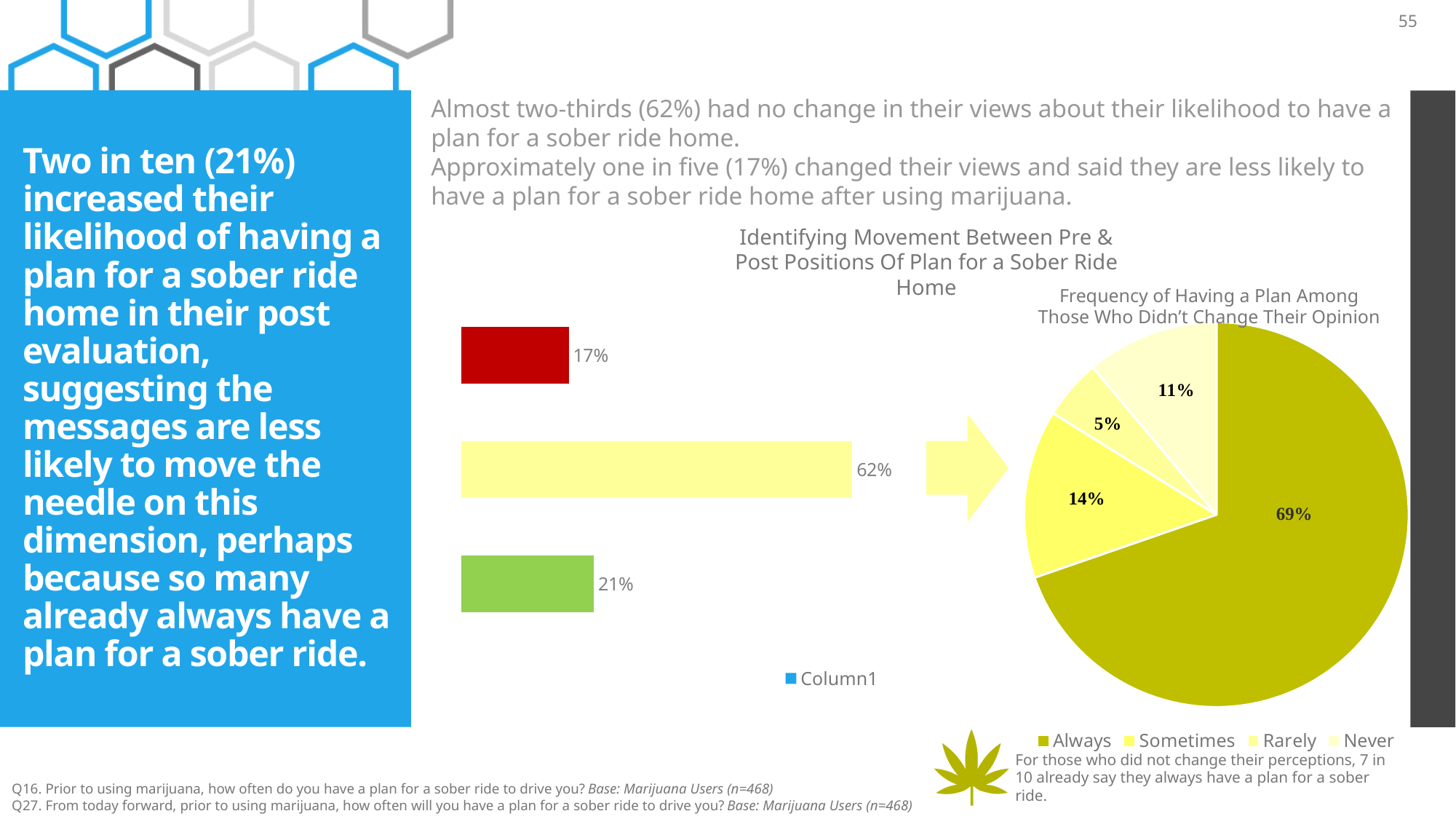
In the bar chart 'Identifying Movement Between Pre & Post Positions Of Plan for a Sober Ride Home', what value is labelled on the middle (yellow) bar? 62% In the bar chart 'Identifying Movement Between Pre & Post Positions Of Plan for a Sober Ride Home', what value is labelled on the bottom (green) bar? 21% In the pie chart 'Frequency of Having a Plan Among Those Who Didn't Change Their Opinion', how many categories does the legend list? 4 In the bar chart 'Identifying Movement Between Pre & Post Positions Of Plan for a Sober Ride Home', what is the difference in percentage points between the middle bar and the top (red) bar? 45 In the pie chart 'Frequency of Having a Plan Among Those Who Didn't Change Their Opinion', what share is labelled for Sometimes? 14% In the pie chart 'Frequency of Having a Plan Among Those Who Didn't Change Their Opinion', what is the difference in percentage points between Sometimes and Never? 3 What type of chart is 'Identifying Movement Between Pre & Post Positions Of Plan for a Sober Ride Home'? Bar chart In the pie chart 'Frequency of Having a Plan Among Those Who Didn't Change Their Opinion', what share is labelled for Rarely? 5% In the pie chart 'Frequency of Having a Plan Among Those Who Didn't Change Their Opinion', which category has the smallest slice? Rarely In the pie chart 'Frequency of Having a Plan Among Those Who Didn't Change Their Opinion', which category has the largest slice? Always In the pie chart 'Frequency of Having a Plan Among Those Who Didn't Change Their Opinion', what share is labelled for Never? 11% In the pie chart 'Frequency of Having a Plan Among Those Who Didn't Change Their Opinion', what share is labelled for Always? 69%